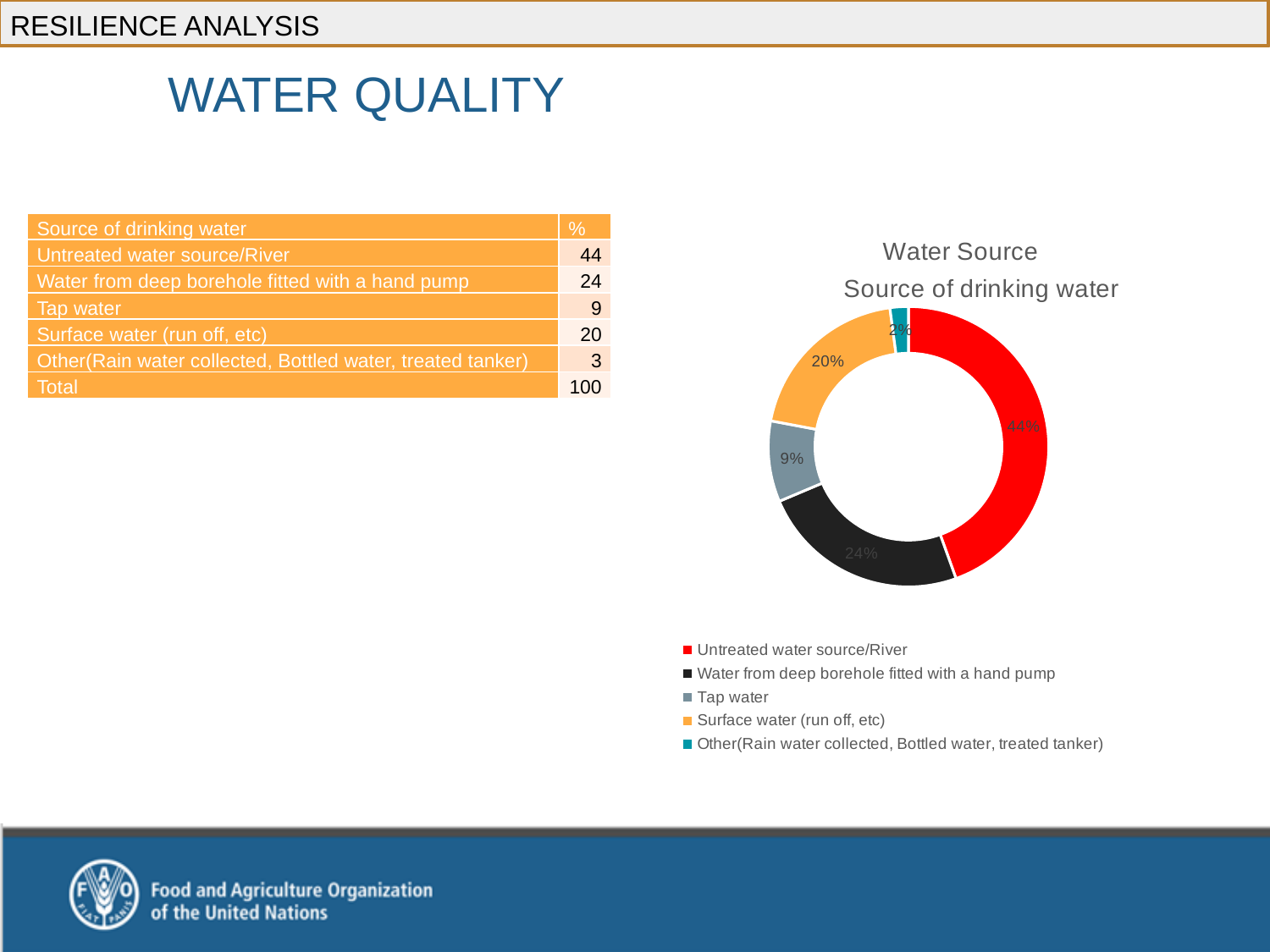
What percentage of the chart is Untreated water source/River? 44% What colour is the slice for Untreated water source/River? Red What percentage of the chart is Surface water (run off, etc)? 20% What percentage of the chart is Water from deep borehole fitted with a hand pump? 24% What is the difference in percentage points between Untreated water source/River and Water from deep borehole fitted with a hand pump? 20 What percentage of the chart is Tap water? 9% Which source of drinking water has the largest share in the chart? Untreated water source/River What is the title of the chart? Source of drinking water How many categories does the chart show? 5 Which is larger in the chart: Tap water or Surface water (run off, etc)? Surface water (run off, etc) Which source of drinking water has the smallest share in the chart? Other(Rain water collected, Bottled water, treated tanker) What type of chart is shown on the slide? Doughnut chart